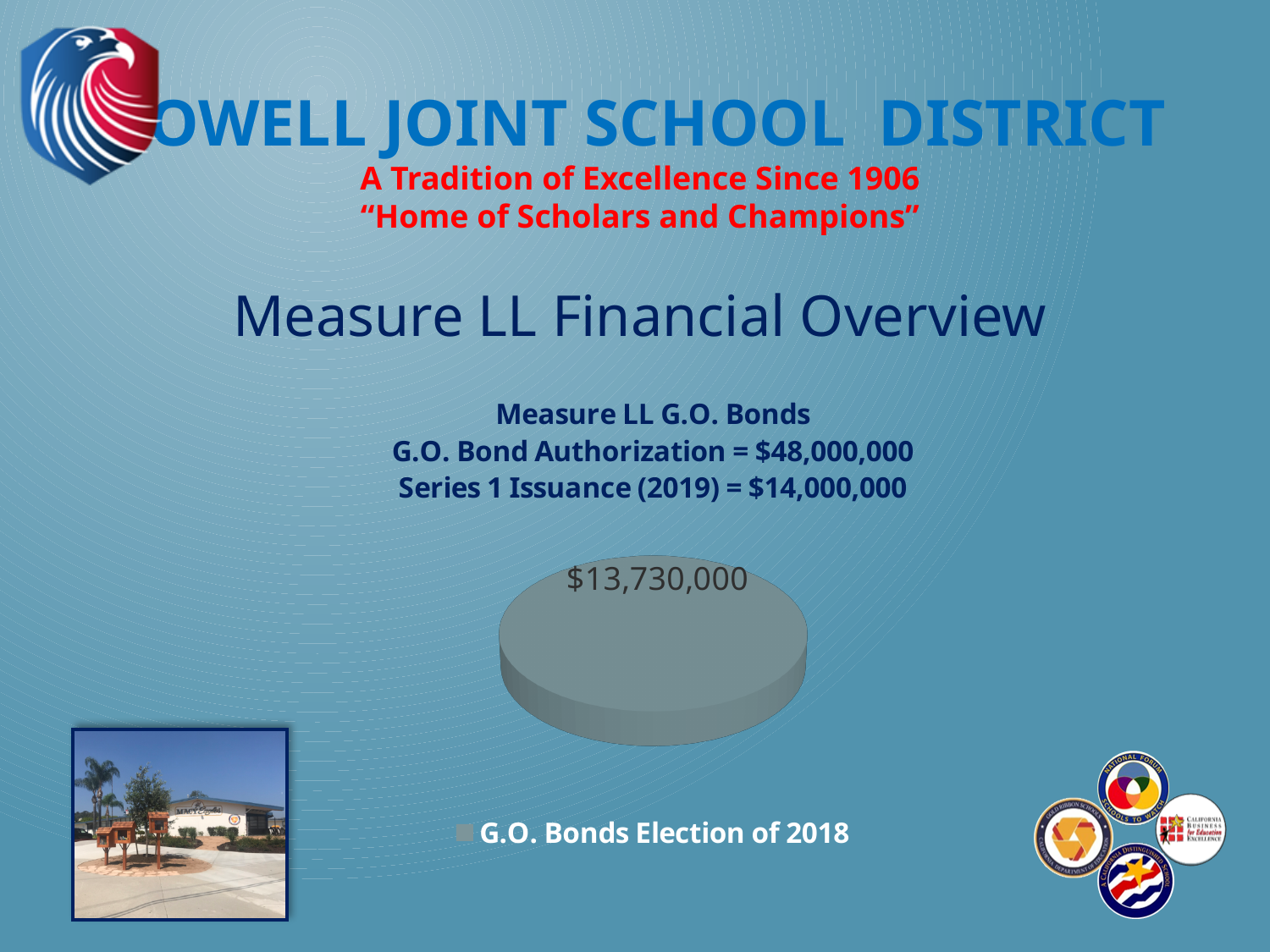
What is the total of all slices in the pie chart? $13,730,000 What value is printed on the pie chart's slice? $13,730,000 What is the value for G.O. Bonds Election of 2018 in the pie chart? $13,730,000 What is the legend entry shown below the pie chart? G.O. Bonds Election of 2018 What is the title of the slide containing the pie chart? Measure LL Financial Overview What kind of chart is shown on the slide? pie chart How many slices does the pie chart have? 1 Is the value shown on the pie chart greater or less than $14,000,000? less What share of the pie does the G.O. Bonds Election of 2018 slice represent? 100% How many entries does the pie chart's legend list? 1